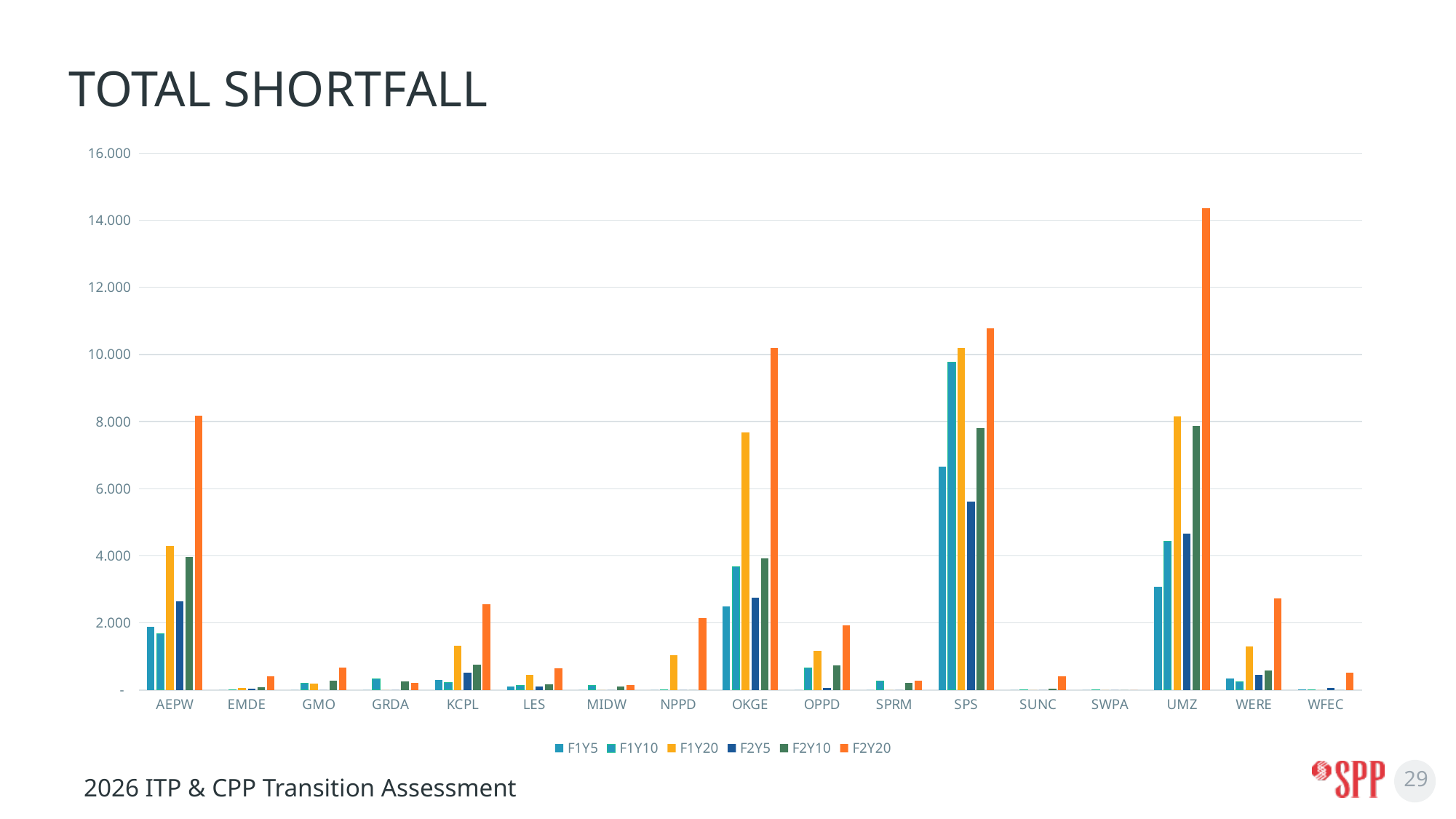
How many series does the legend list? 6 What kind of chart is shown on the slide? bar chart Is the F2Y20 value for SPS greater or less than 10.000? greater What is the title of the chart? TOTAL SHORTFALL Which series has the highest value for SPS? F2Y20 Which category has the tallest bar in the chart? UMZ Which series is shown in orange in the legend? F2Y20 Is the F2Y20 value for UMZ greater or less than 12.000? greater Is the F1Y20 value for OKGE greater or less than 8.000? less Which is larger, the F1Y20 value for AEPW or the F1Y20 value for OKGE? OKGE How many categories are shown along the x axis of the chart? 17 Which is larger, the F2Y20 value for SPS or the F2Y20 value for UMZ? UMZ